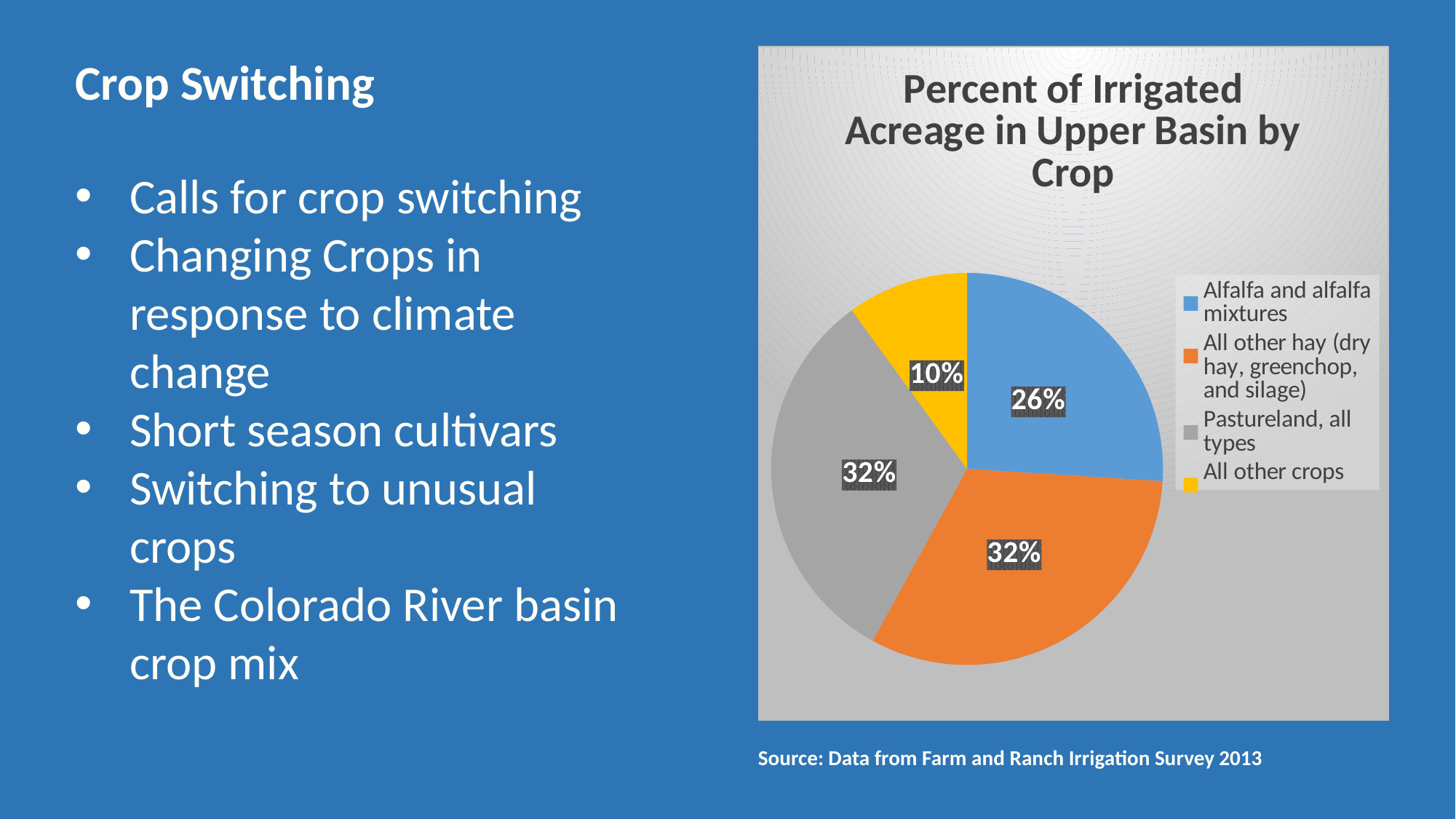
What is the title of the chart? Percent of Irrigated Acreage in Upper Basin by Crop What percentage of irrigated acreage is All other hay (dry hay, greenchop, and silage)? 32% Which colour represents Pastureland, all types in the pie chart? gray What percentage of irrigated acreage is Alfalfa and alfalfa mixtures? 26% Which is larger, the share for Alfalfa and alfalfa mixtures or the share for All other crops? Alfalfa and alfalfa mixtures What percentage of irrigated acreage is All other crops? 10% Which crop category has the smallest share of irrigated acreage? All other crops What is the difference in percentage points between All other hay (dry hay, greenchop, and silage) and Alfalfa and alfalfa mixtures? 6 What is the difference in percentage points between Pastureland, all types and All other crops? 22 How many crop categories does the pie chart show? 4 What kind of chart is shown on the slide? pie chart What percentage of irrigated acreage is Pastureland, all types? 32%